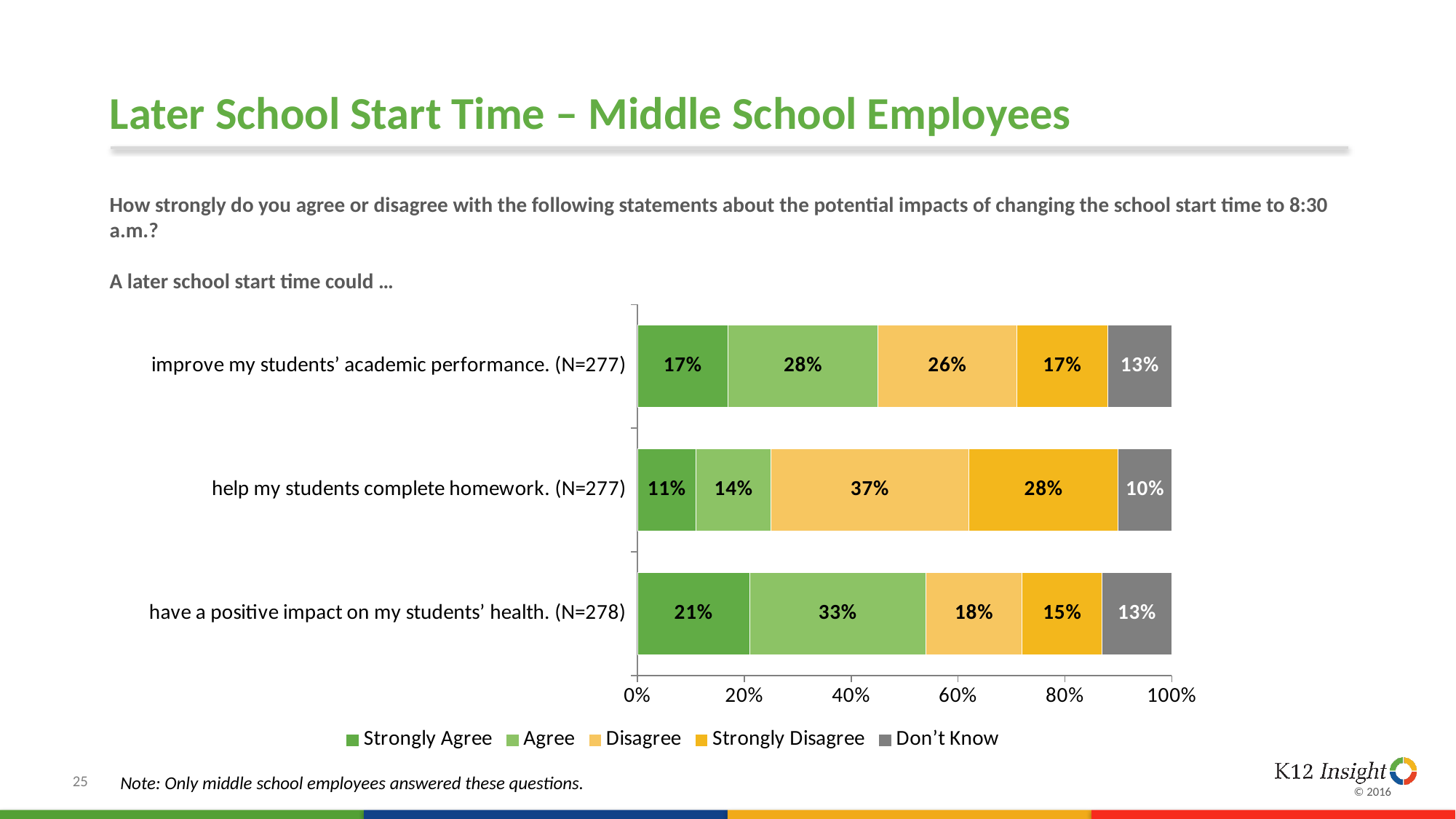
What is the combined percentage of 'Strongly Agree' and 'Agree' for the statement about a positive impact on students' health? 54% What percentage of respondents agree that a later school start time could have a positive impact on their students' health? 33% How many series does the legend list? 5 What percentage of respondents disagree that a later school start time could help their students complete homework? 37% Which statement has the lowest 'Agree' percentage? help my students complete homework. (N=277) What percentage of middle school employees strongly agree that a later school start time could improve their students' academic performance? 17% What percentage answered 'Don't Know' for the statement about helping students complete homework? 10% How many statements are shown in the chart? 3 What is the difference between the 'Strongly Disagree' percentages for the homework statement and the health statement? 13% Which statement has the highest 'Strongly Agree' percentage? have a positive impact on my students' health. (N=278) Is the 'Disagree' percentage larger for the academic performance statement or the health statement? academic performance What kind of chart is shown on the slide? stacked bar chart